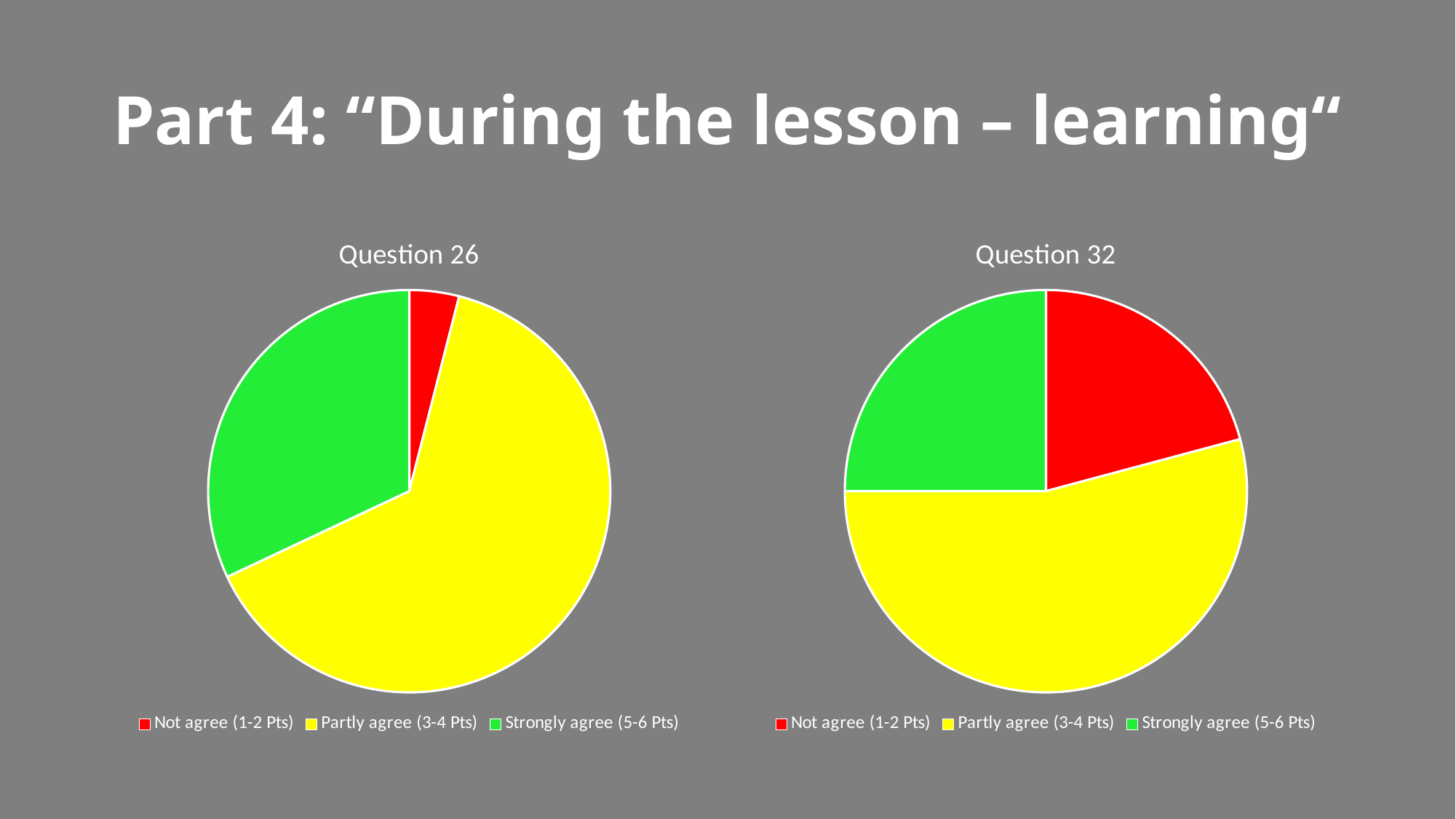
In the "Question 26" chart, which category has the largest slice? Partly agree (3-4 Pts) How many entries does the legend of the "Question 32" chart list? 3 In the "Question 26" chart, which category has the smallest slice? Not agree (1-2 Pts) In the "Question 32" chart, which category has the largest slice? Partly agree (3-4 Pts) How many pie charts are shown on the slide? 2 What kind of chart is the "Question 32" chart? Pie chart What is the title of the pie chart on the right side of the slide? Question 32 How many slices does the "Question 26" pie chart have? 3 In the "Question 32" chart, which slice is larger: Not agree (1-2 Pts) or Partly agree (3-4 Pts)? Partly agree (3-4 Pts) In the "Question 26" chart, what colour represents Strongly agree (5-6 Pts)? Green What kind of chart is the "Question 26" chart? Pie chart In the "Question 26" chart, which slice is larger: Partly agree (3-4 Pts) or Strongly agree (5-6 Pts)? Partly agree (3-4 Pts)